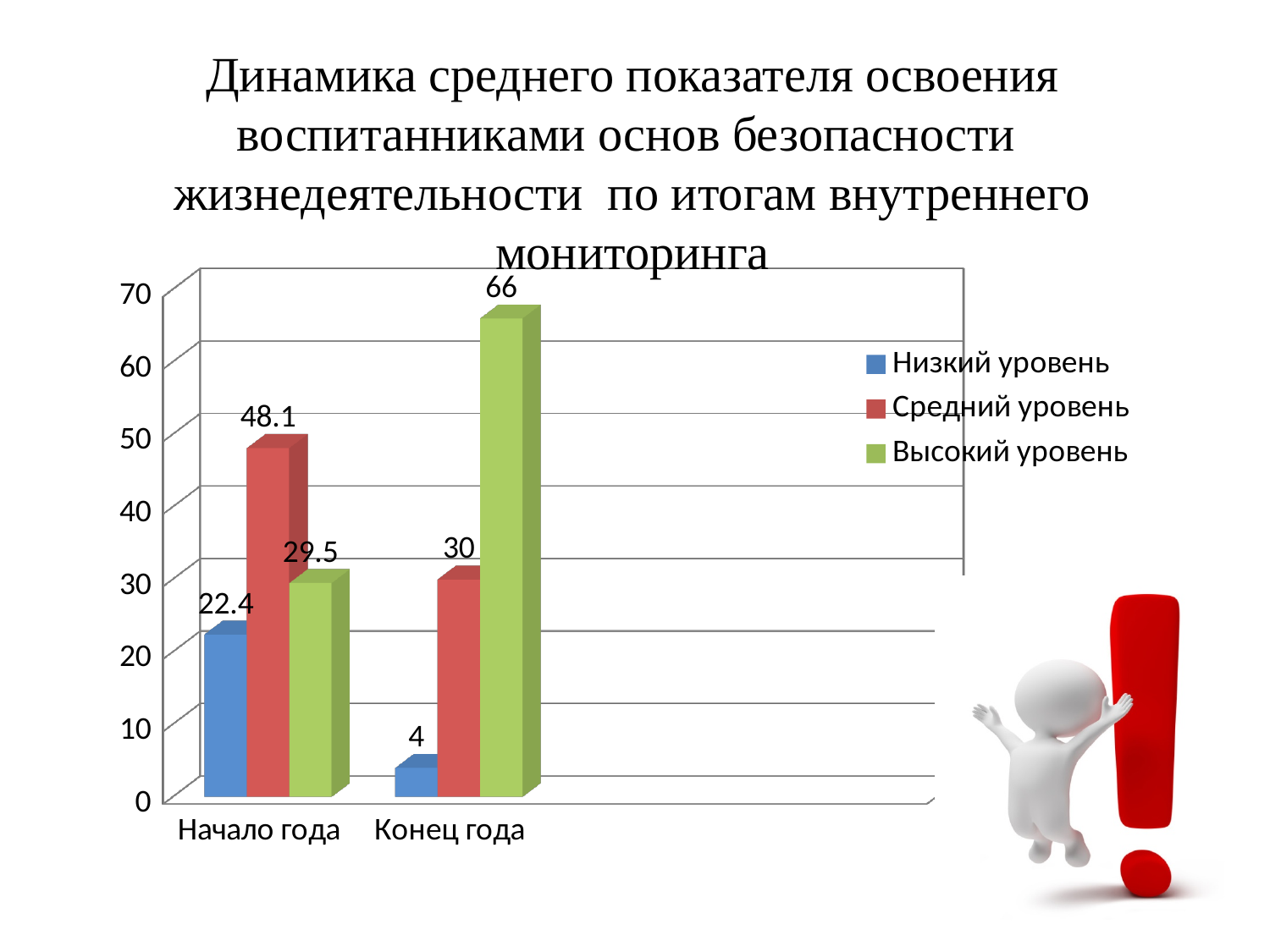
What is the value for Низкий уровень at Начало года? 22.4 Which series has the lowest value at Начало года? Низкий уровень What is the value for Высокий уровень at Конец года? 66 Which series has the highest value at Конец года? Высокий уровень What is the difference between the Высокий уровень values at Конец года and Начало года? 36.5 How many series does the legend list? 3 Does the value for Низкий уровень rise or fall from Начало года to Конец года? fall What is the value for Низкий уровень at Конец года? 4 What kind of chart is shown on the slide? bar chart Which is larger: Средний уровень at Начало года or Средний уровень at Конец года? Начало года How many categories are shown on the x axis? 2 What is the value for Средний уровень at Начало года? 48.1